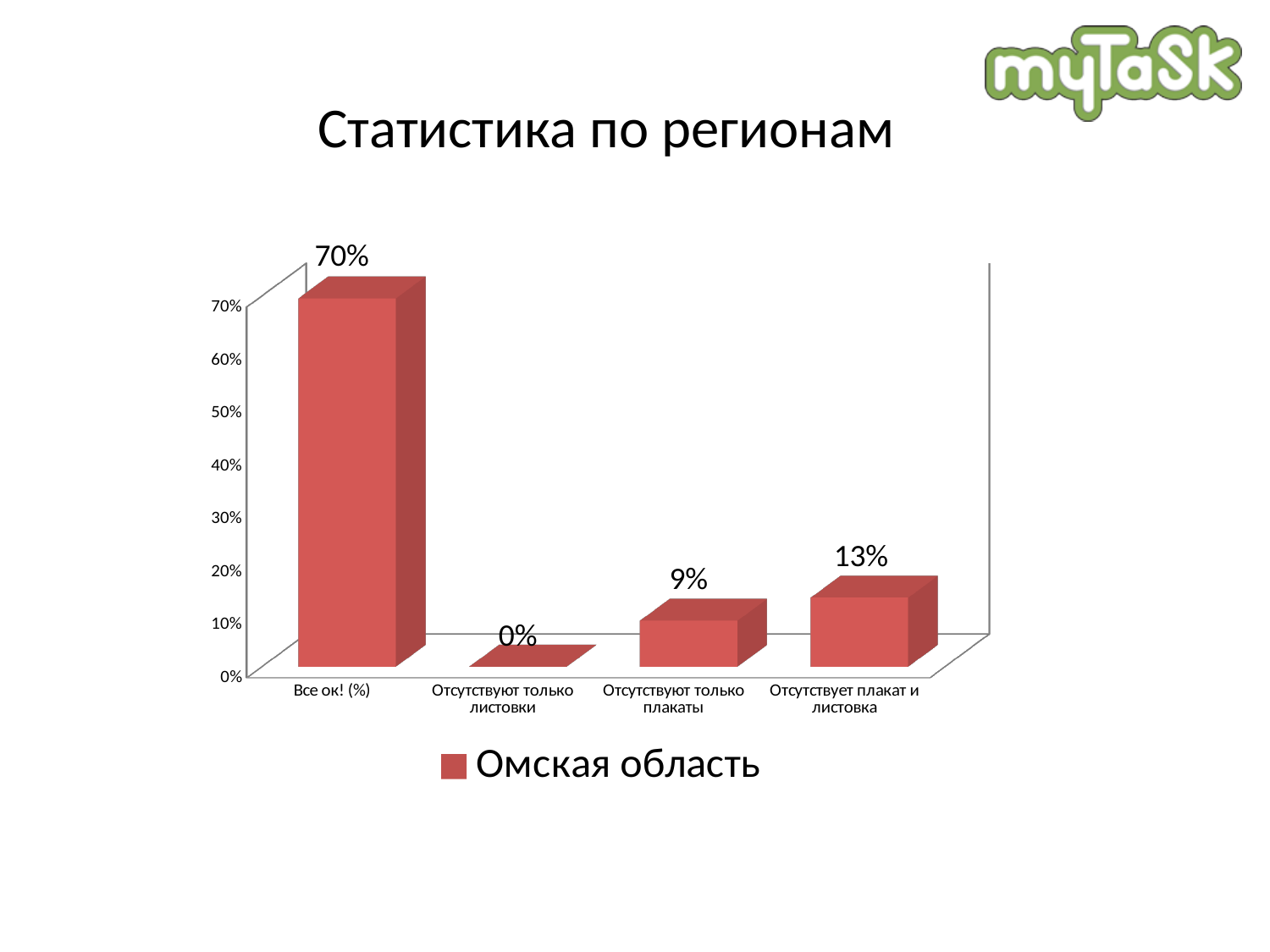
How many series does the legend list? 1 What is the value for "Отсутствуют только плакаты"? 9% Which category has the lowest value? Отсутствуют только листовки How many categories are shown on the x axis? 4 What is the value for "Отсутствует плакат и листовка"? 13% What is the difference between the values for "Все ок! (%)" and "Отсутствует плакат и листовка"? 57% What series name is shown in the legend? Омская область What is the value for "Отсутствуют только листовки"? 0% Which is larger: the value for "Отсутствуют только плакаты" or for "Отсутствует плакат и листовка"? Отсутствует плакат и листовка Which category has the highest value? Все ок! (%) What is the value for "Все ок! (%)"? 70% What kind of chart is shown on the slide? Bar chart